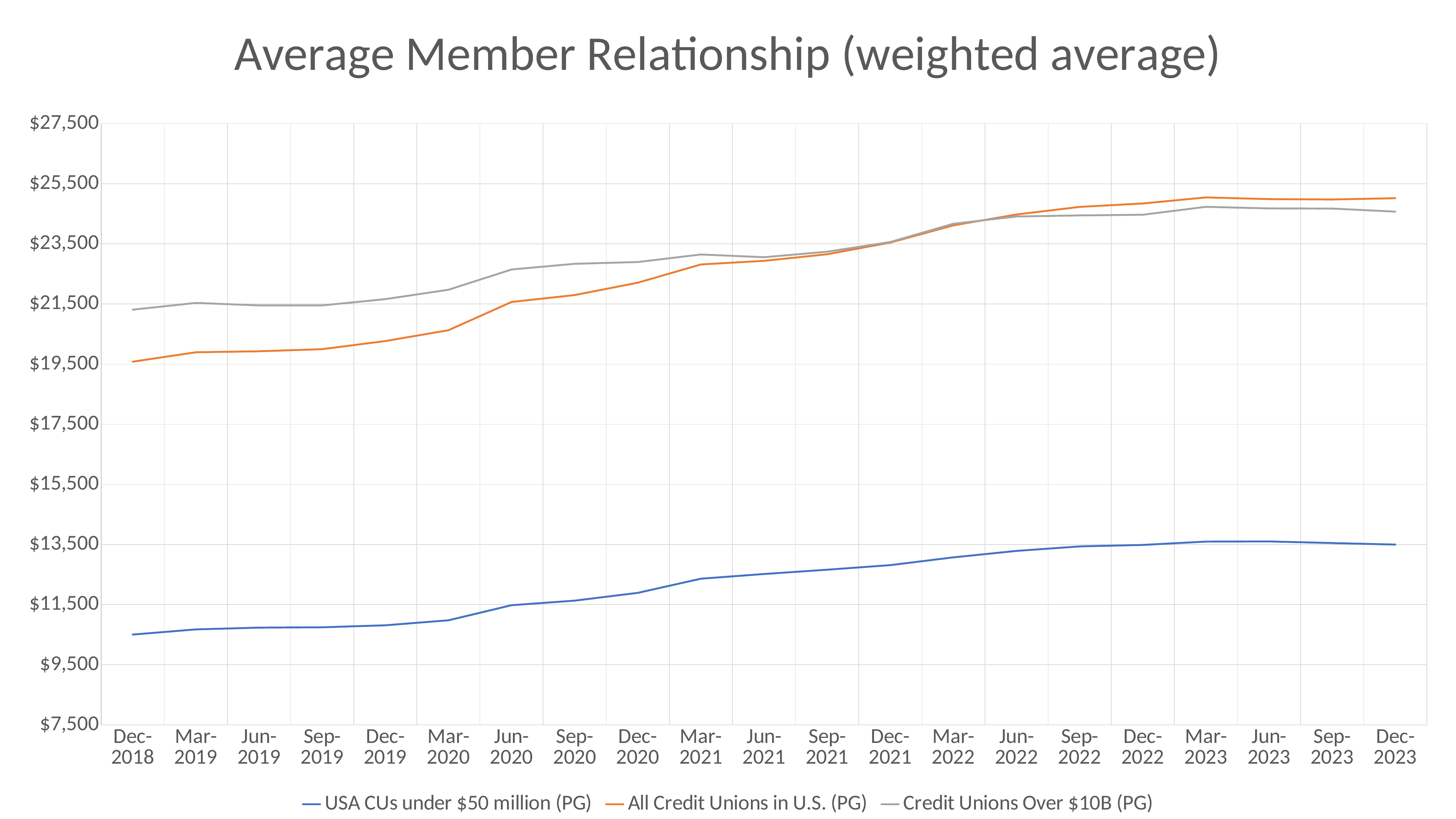
What is the title of the chart? Average Member Relationship (weighted average) At Dec-2018, which series has the higher value: All Credit Unions in U.S. (PG) or Credit Unions Over $10B (PG)? Credit Unions Over $10B (PG) Is the value for Credit Unions Over $10B (PG) at Dec-2018 greater or less than $19,500? greater Is the value for USA CUs under $50 million (PG) at Dec-2023 greater or less than $11,500? greater Is the value for All Credit Unions in U.S. (PG) at Dec-2018 greater or less than $21,500? less Does the USA CUs under $50 million (PG) line generally rise or fall from Dec-2018 to Dec-2023? Rise What kind of chart is shown on the slide? Line chart How many time points are shown along the x axis? 21 How many series does the legend list? 3 At Dec-2023, which series has the lower value: USA CUs under $50 million (PG) or All Credit Unions in U.S. (PG)? USA CUs under $50 million (PG)